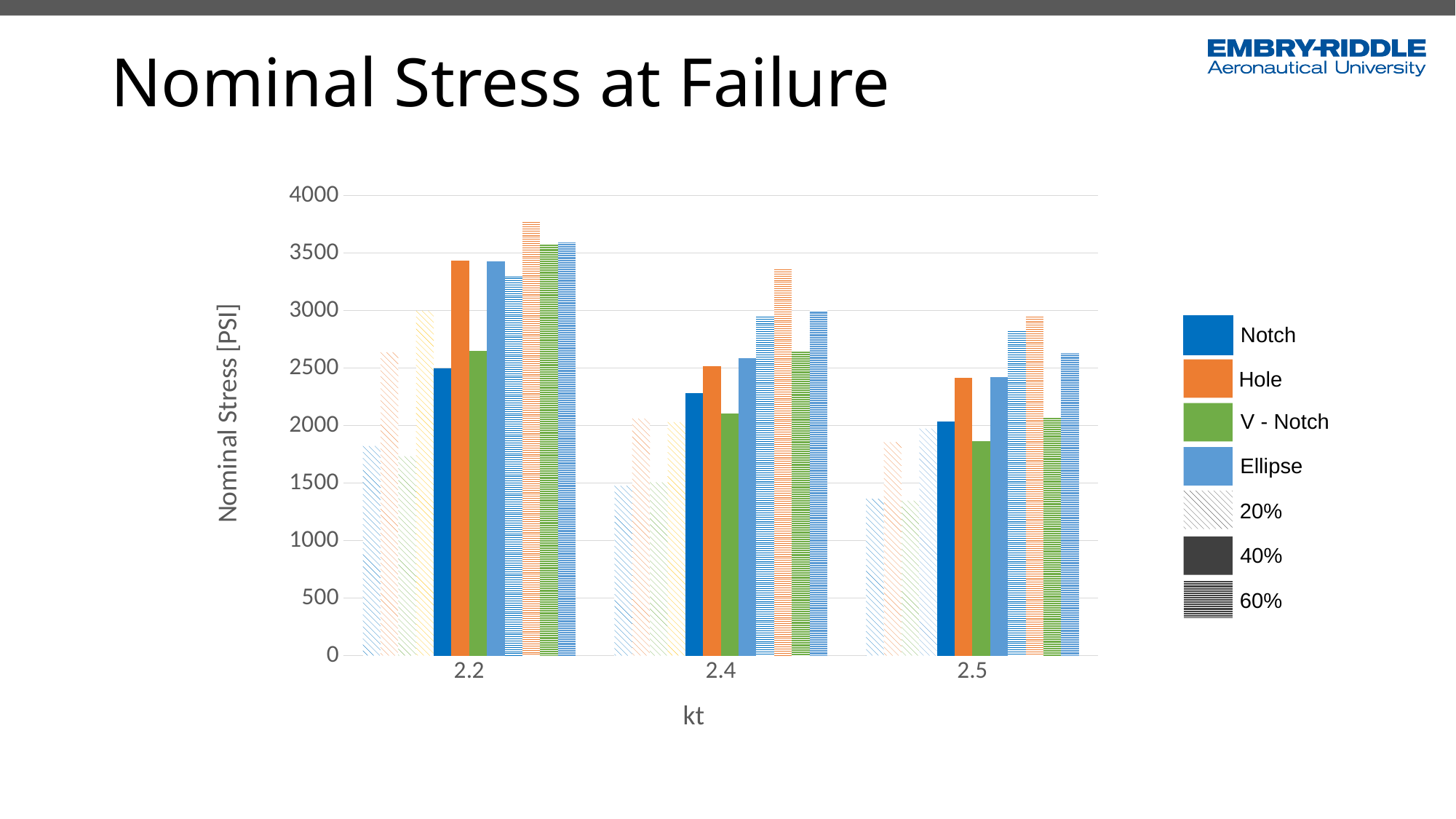
What is the title of the chart? Nominal Stress at Failure At kt = 2.2, which is larger among the solid (40%) bars: Hole or V - Notch? Hole How many kt categories are shown on the x axis? 3 Is the solid (40%) V - Notch bar at kt = 2.5 greater or less than 2000? less What kind of chart is shown on the slide? bar chart Among the solid (40%) bars at kt = 2.5, which specimen type has the lowest nominal stress? V - Notch What is the label of the vertical axis? Nominal Stress [PSI] Is the 60% Hole bar at kt = 2.2 greater or less than 3500? greater Do the solid (40%) Notch bars rise or fall as kt increases from 2.2 to 2.5? fall Is the solid (40%) Hole bar at kt = 2.2 greater or less than 3000? greater How many entries does the legend list? 7